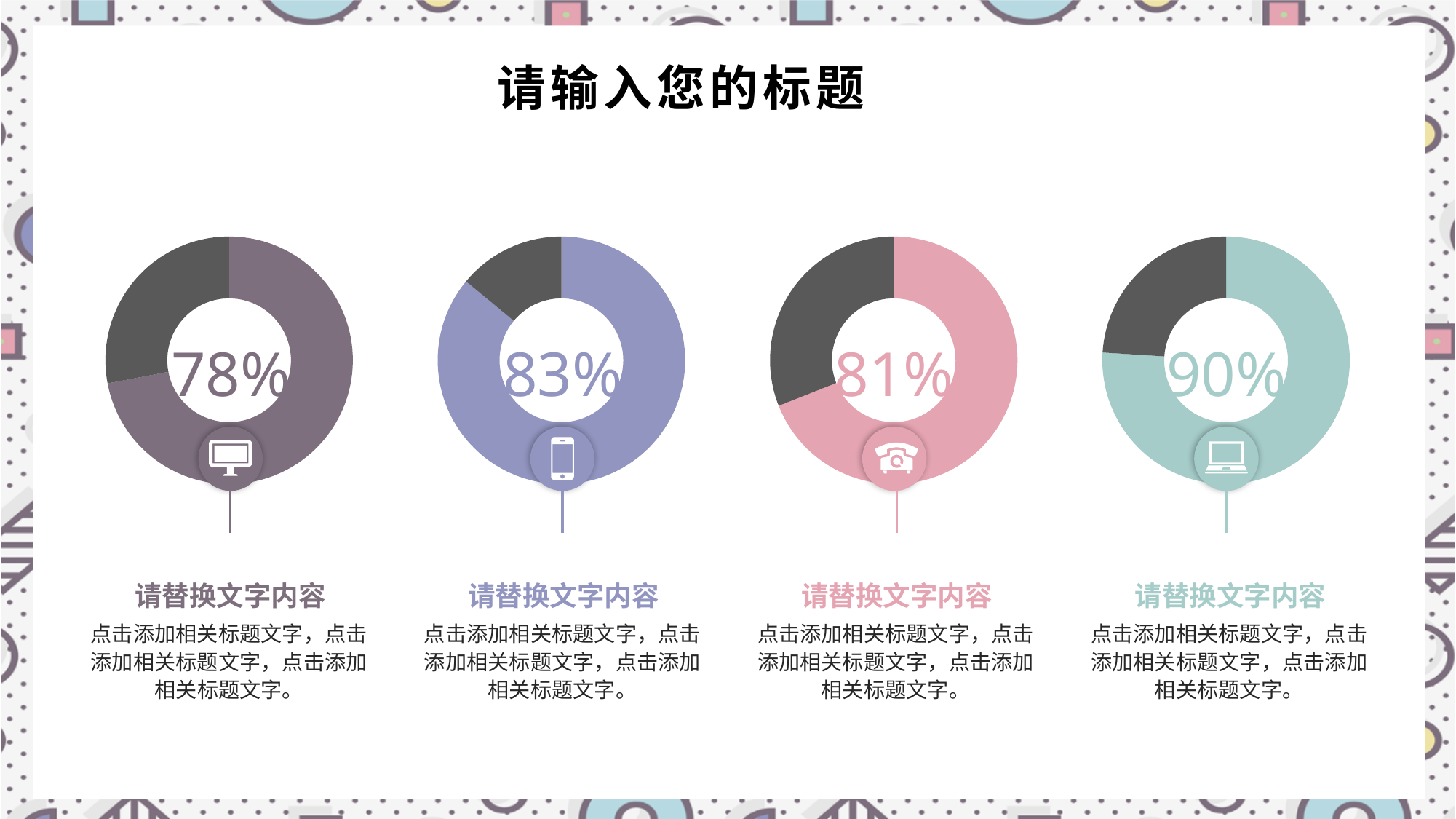
What is the difference between the percentages shown in the second and third donut charts? 2% What is the difference between the percentage in the rightmost donut chart and the percentage in the leftmost donut chart? 12% Which donut chart shows the lowest percentage? The leftmost one (monitor icon), 78% What colour is the filled portion of the third donut chart from the left? Pink What type of chart is used on this slide? Donut chart What percentage is shown in the leftmost donut chart (with the monitor icon)? 78% How many donut charts are on the slide? 4 What percentage is shown in the third donut chart from the left (with the telephone icon)? 81% What percentage is shown in the rightmost donut chart (with the laptop icon)? 90% Which is larger: the percentage in the second donut chart (phone icon) or the third donut chart (telephone icon)? The second donut chart, 83% What percentage is shown in the second donut chart from the left (with the mobile phone icon)? 83% Which donut chart shows the highest percentage? The rightmost one (laptop icon), 90%